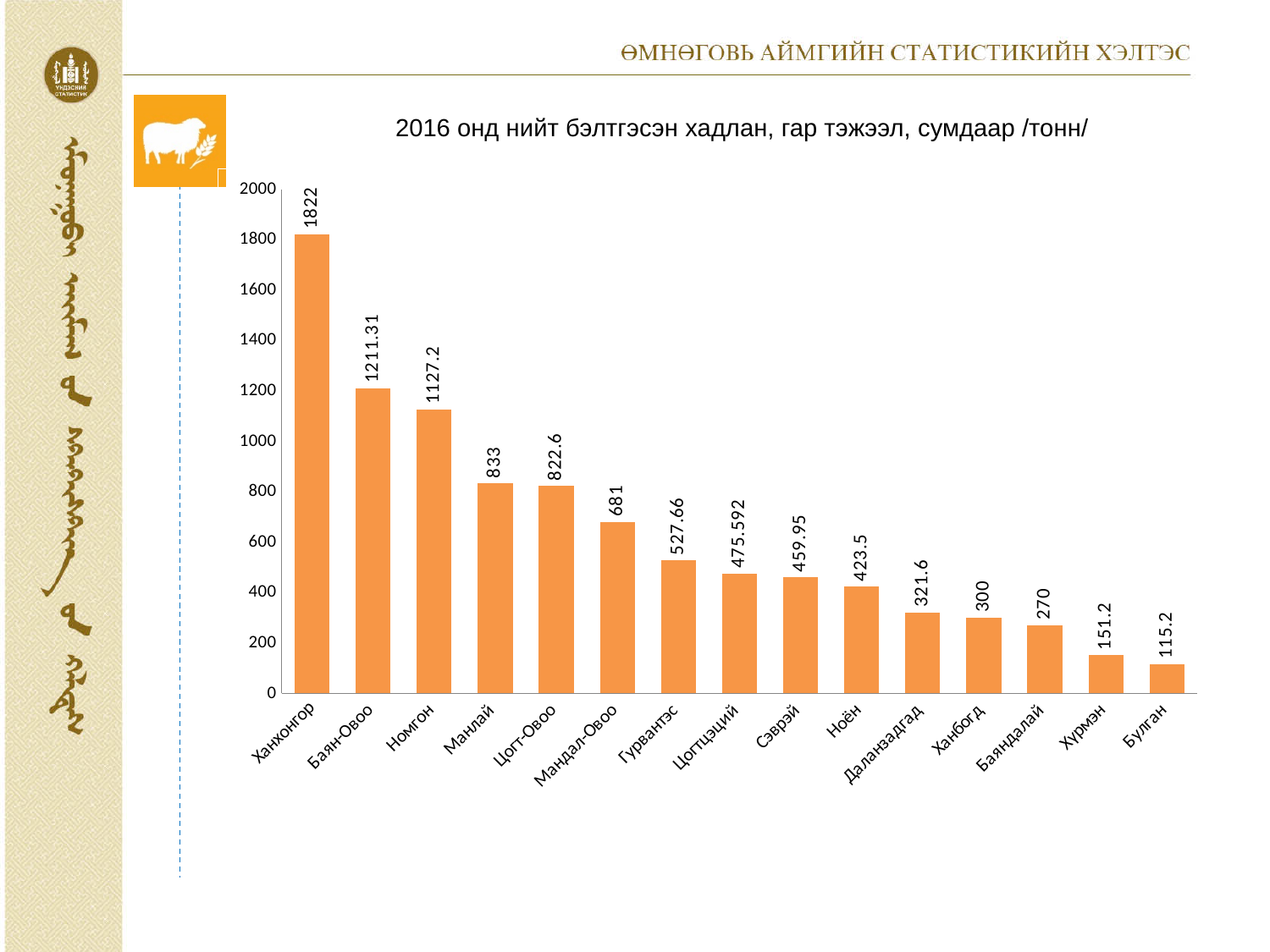
What is the difference between the values for Ханхонгор and Баян-Овоо? 610.69 What is the difference between the values for Ханбогд and Баяндалай? 30 Which category has the lowest value? Булган Do the values rise or fall from left to right along the x axis? fall What is the value for Цогтцэций? 475.592 How many categories are shown on the x axis? 15 What is the value for Даланзадгад? 321.6 Which is larger, the value for Номгон or the value for Манлай? Номгон What is the value for Ханхонгор? 1822 What kind of chart is shown on the slide? bar chart Is the value for Мандал-Овоо greater or less than 600? greater Which category has the highest value? Ханхонгор